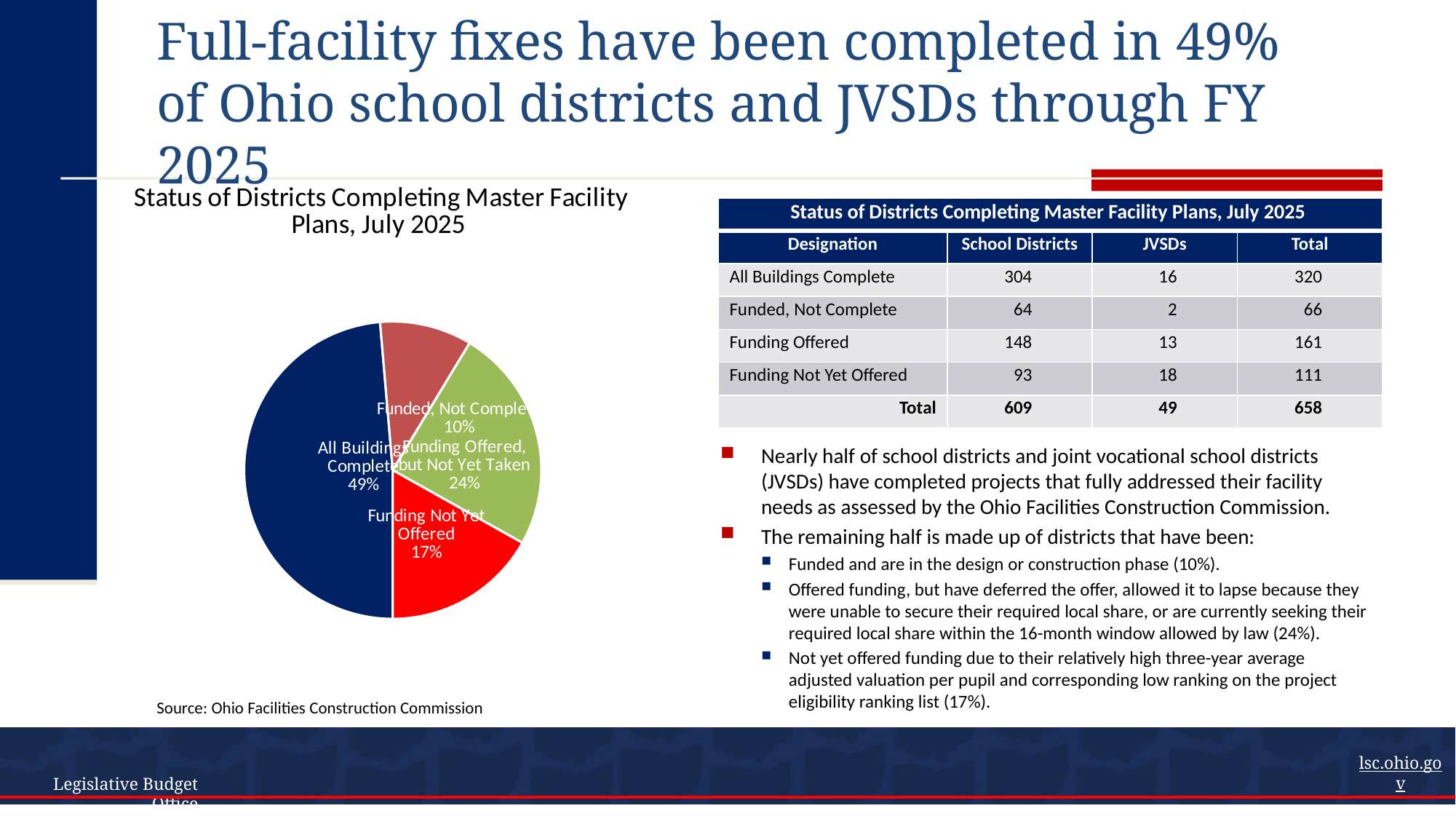
What is the title of the pie chart? Status of Districts Completing Master Facility Plans, July 2025 Which slice of the pie chart is the smallest? Funded, Not Complete What share of the pie does the All Buildings Complete slice represent? 49% What kind of chart is shown on the slide? Pie chart What is the difference in percentage points between the All Buildings Complete slice and the Funding Offered, but Not Yet Taken slice? 25 percentage points What percentage is shown for the Funding Not Yet Offered slice? 17% How many slices does the pie chart have? 4 Which slice of the pie chart is the largest? All Buildings Complete Which is larger in the pie chart: Funding Not Yet Offered or Funded, Not Complete? Funding Not Yet Offered What percentage is shown for the Funding Offered, but Not Yet Taken slice? 24% What source is cited below the pie chart? Ohio Facilities Construction Commission What percentage is shown for the Funded, Not Complete slice? 10%